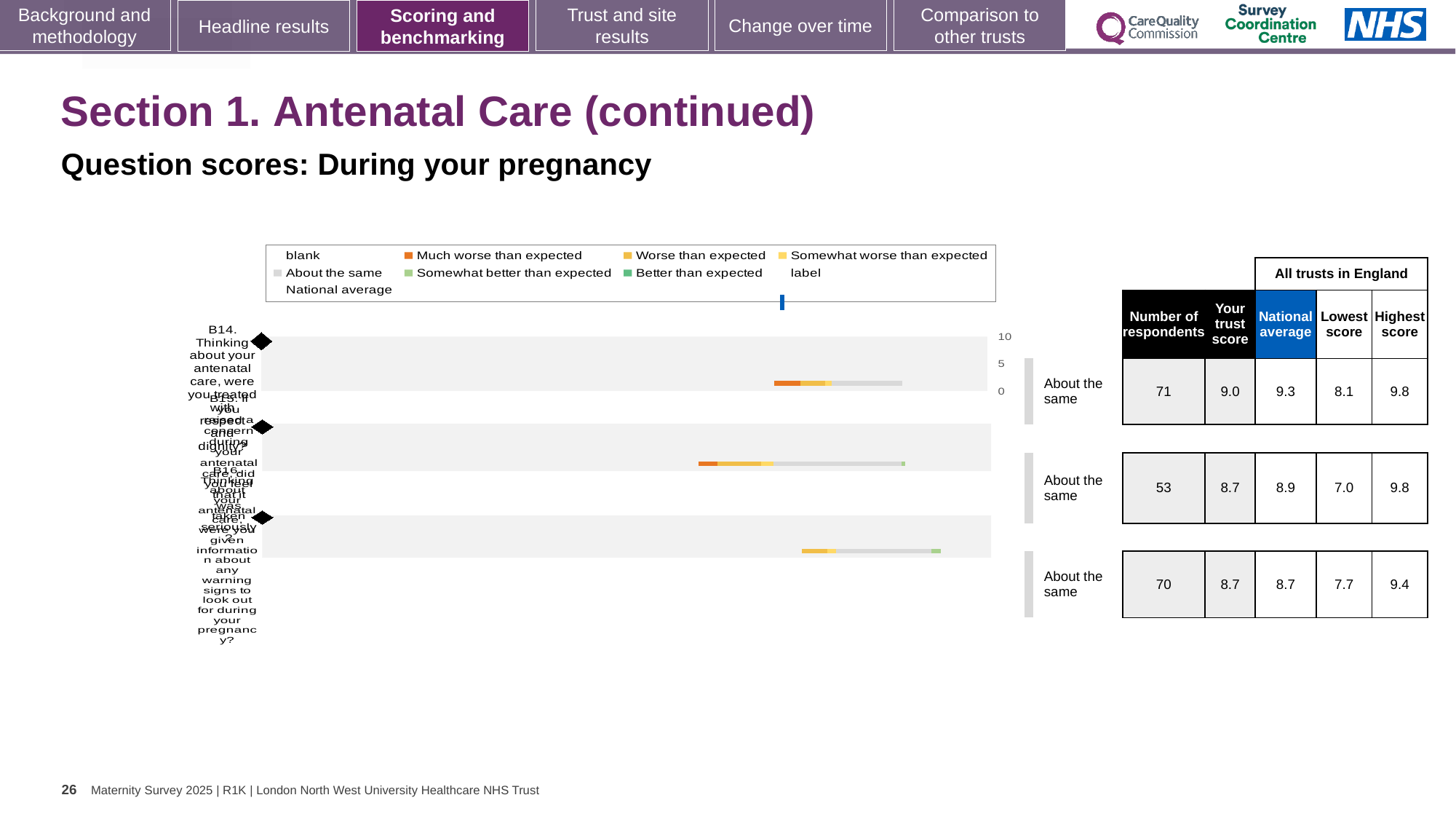
In the table beside the chart, what is the number of respondents for the top row (B14)? 71 Which colour does the legend use for 'Much worse than expected'? orange What kind of chart is shown on the slide? bar chart In the table beside the chart, which row has the lowest value in the 'Lowest score' column? the middle row (7.0) How many horizontal bars does the chart contain? 3 In the table beside the chart, what is the number of respondents for the middle row? 53 According to the legend, what does the vertical blue line on the chart represent? National average In the table beside the chart, what is the 'Highest score' for the bottom row? 9.4 What benchmark category is shown beside each of the three bars? About the same In the table beside the chart, what is the difference between the national average and the trust score for the middle row? 0.2 In the table beside the chart, which is larger for the top row: 'Your trust score' or 'National average'? National average In the table beside the chart, what is 'Your trust score' for the top row (B14)? 9.0